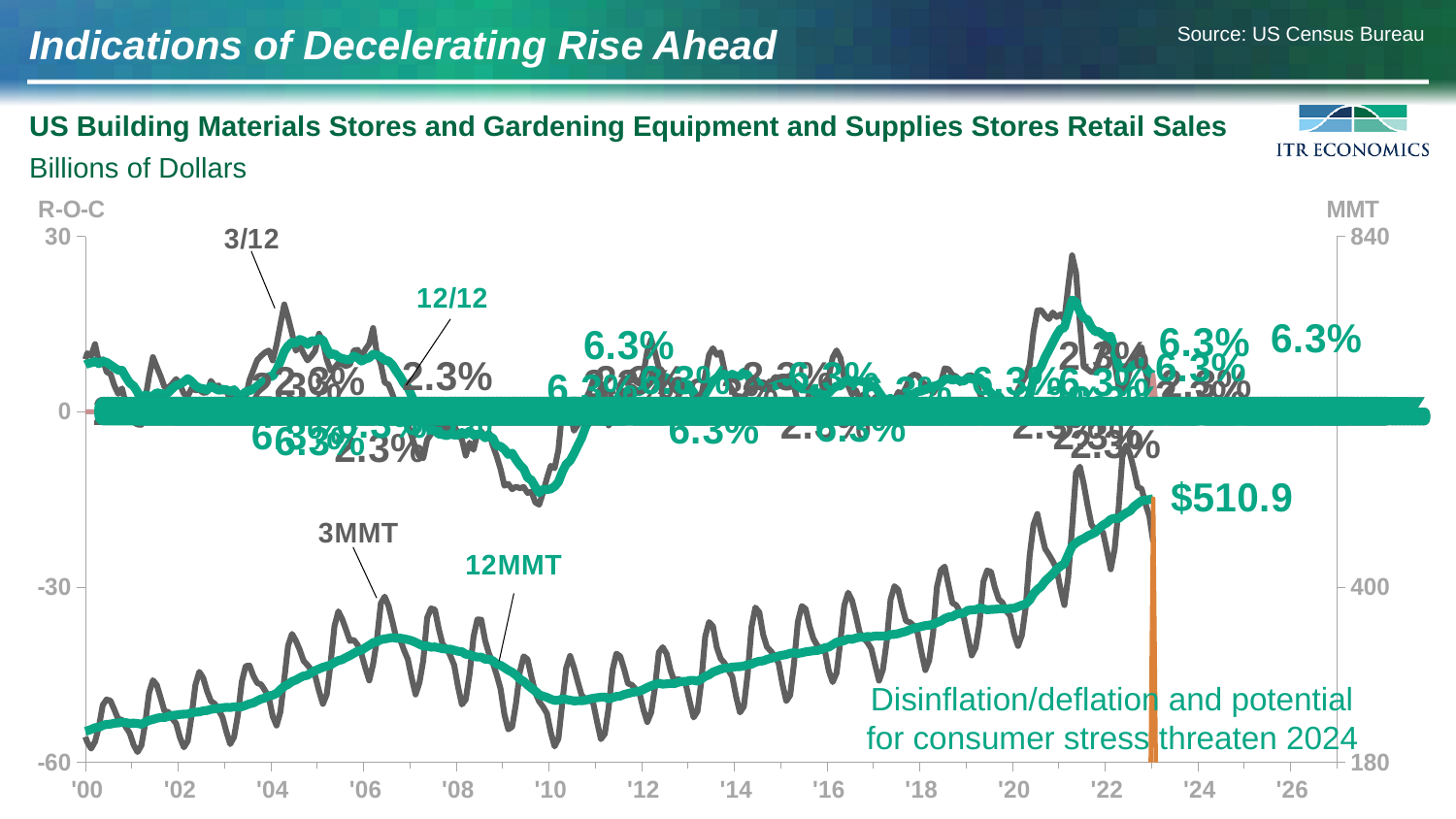
Is the 12MMT value in '00 greater or less than 400 on the MMT axis? less Is the 12/12 value around '09 greater or less than 0 on the R-O-C axis? less What is the title of the chart? US Building Materials Stores and Gardening Equipment and Supplies Stores Retail Sales Is the 3/12 peak around '21 greater or less than 0 on the R-O-C axis? greater What is the latest labeled value of the 12MMT series? $510.9 How many series are plotted on the chart? 4 What kind of chart is shown on the slide? line chart What is the source cited for the chart data? US Census Bureau Around '21, which series reaches a higher peak, 3/12 or 12/12? 3/12 Does the 12MMT series generally rise or fall from '00 to '22? rise